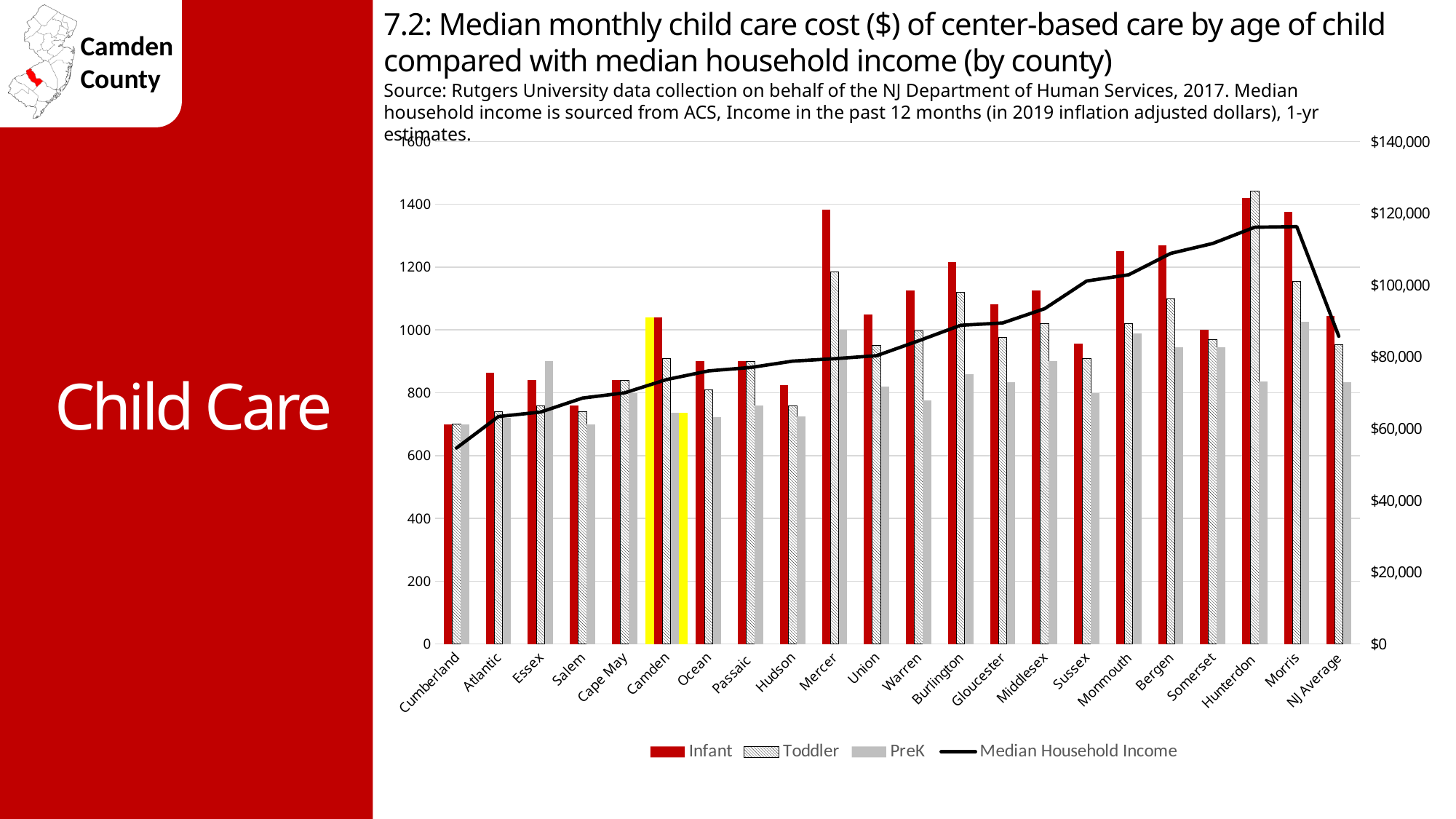
Which category has the highest Toddler bar? Hunterdon Is the Infant value for Cumberland greater or less than 800? less Is the Toddler value for Camden greater or less than 1000? less Is the Infant value for Mercer greater or less than 1200? greater How many counties/categories are shown on the x axis? 22 Does the Median Household Income line generally rise or fall from Cumberland to Morris? rise Which is larger, the Infant value for Mercer or the Infant value for Camden? Mercer Which county's bars are highlighted in yellow? Camden What kind of chart is this? Bar chart with a line Which is larger for Essex, the PreK value or the Infant value? PreK Which category has the lowest Infant bar? Cumberland How many series does the legend list? 4